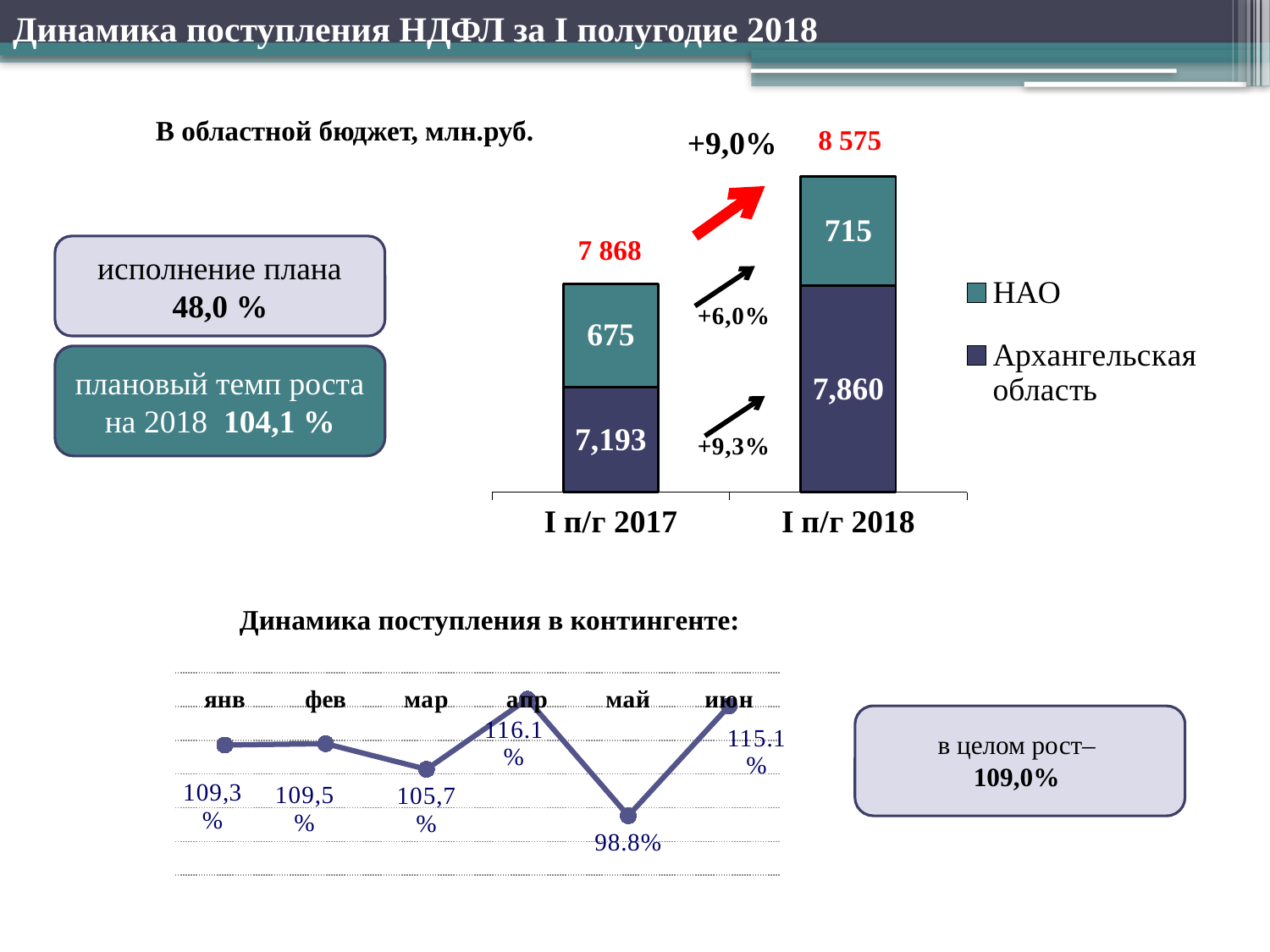
In the stacked bar chart 'В областной бюджет, млн.руб.', how many series does the legend list? 2 In the stacked bar chart 'В областной бюджет, млн.руб.', which series is larger in I п/г 2018, НАО or Архангельская область? Архангельская область In the line chart 'Динамика поступления в контингенте', which month has the highest value? апр In the line chart 'Динамика поступления в контингенте', how many months are plotted? 6 In the line chart 'Динамика поступления в контингенте', which month has the lowest value? май In the line chart 'Динамика поступления в контингенте', what is the value for май? 98.8% In the stacked bar chart 'В областной бюджет, млн.руб.', what is the total of the I п/г 2017 bar? 7 868 In the stacked bar chart 'В областной бюджет, млн.руб.', what is the value for Архангельская область in I п/г 2018? 7,860 What kind of chart is 'Динамика поступления в контингенте'? Line chart In the stacked bar chart 'В областной бюджет, млн.руб.', what is the value for НАО in I п/г 2017? 675 In the stacked bar chart 'В областной бюджет, млн.руб.', what is the difference between the НАО values for I п/г 2018 and I п/г 2017? 40 In the stacked bar chart 'В областной бюджет, млн.руб.', what is the total of the I п/г 2018 bar? 8 575